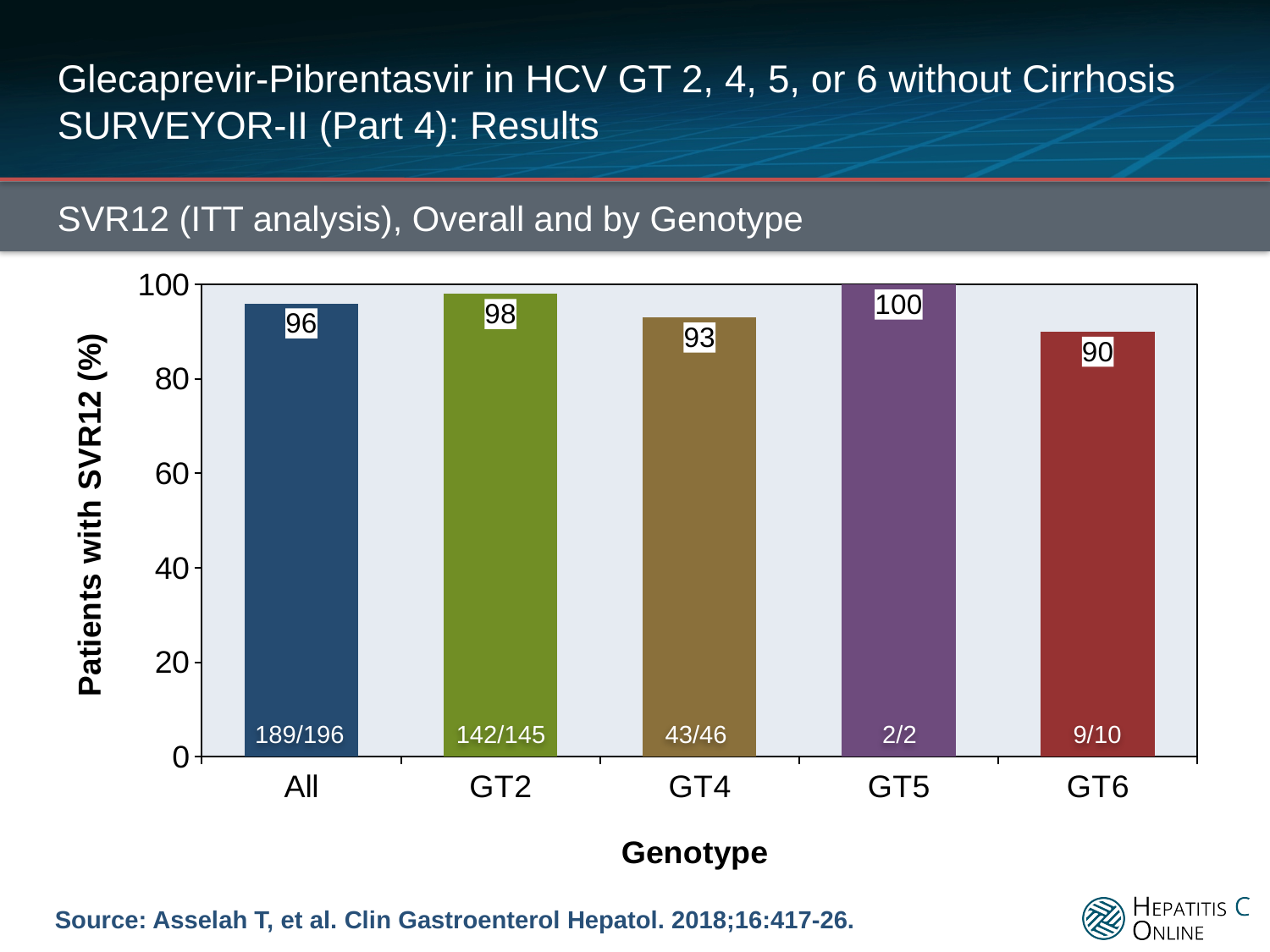
What is the SVR12 rate for GT6? 90 How many genotype categories are shown on the x axis? 5 Which has a higher SVR12 rate, GT2 or GT4? GT2 What fraction of patients is shown at the base of the GT4 bar? 43/46 Which genotype has the lowest SVR12 rate? GT6 What is the difference in SVR12 rate between GT5 and GT6? 10 What kind of chart is shown on the slide? Bar chart What is the title of the chart? SVR12 (ITT analysis), Overall and by Genotype What is the label of the y axis? Patients with SVR12 (%) What is the SVR12 rate for GT2? 98 What is the SVR12 rate for the All group? 96 Which genotype has the highest SVR12 rate? GT5